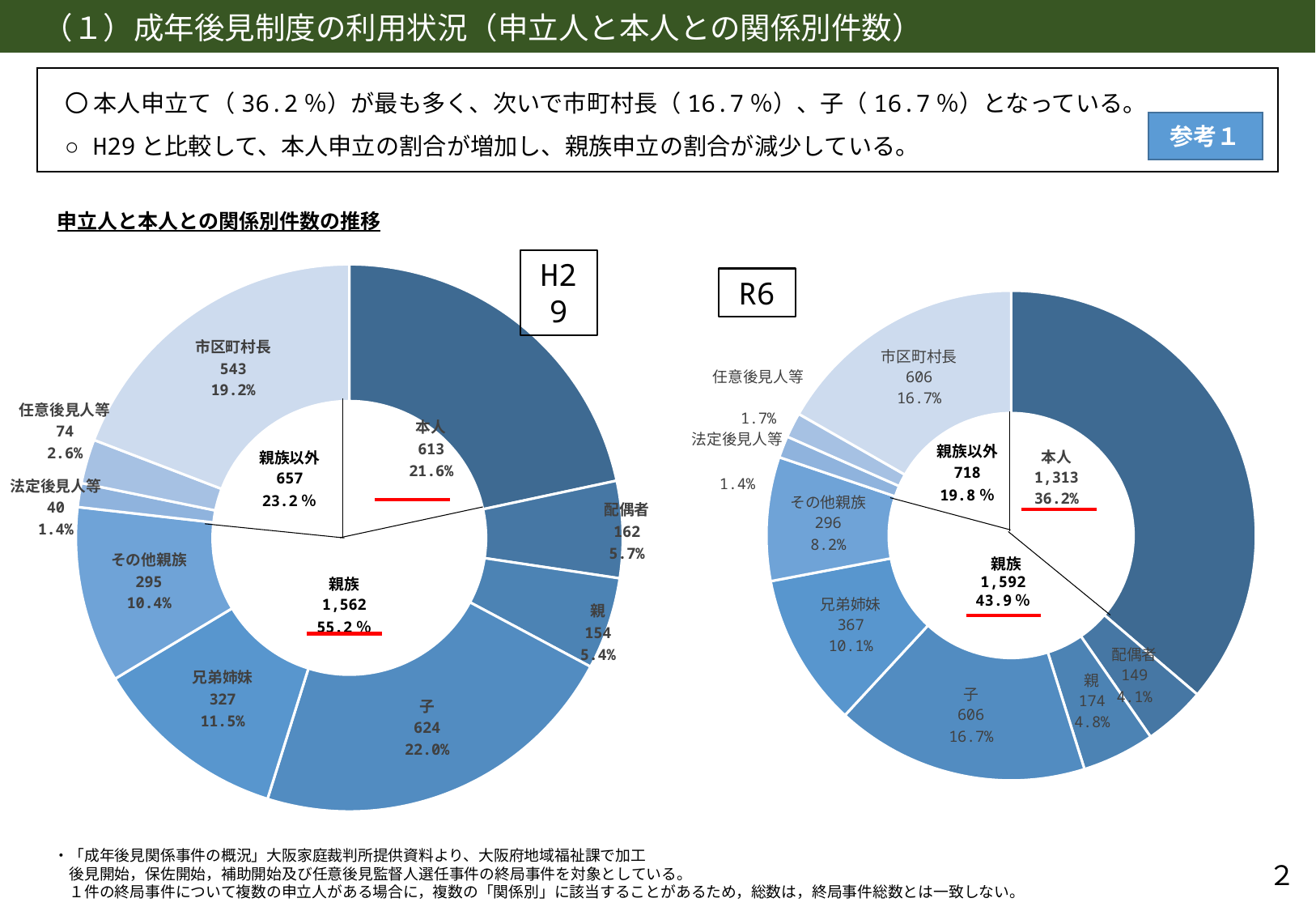
In the H29 chart, what percentage is shown for 親族 in the inner ring? 55.2% In the R6 chart, which has more cases, 兄弟姉妹 or その他親族? 兄弟姉妹 In the R6 chart, what is the number of cases for 市区町村長? 606 In the H29 chart, which category has the largest number of cases? 子 What type of chart is used on this slide? Donut (pie) chart In the R6 chart, what percentage is shown for 本人? 36.2% In the R6 chart, what is the number of cases for 親族以外? 718 In the H29 chart, what is the number of cases for 本人? 613 What is the difference in 本人 cases between R6 and H29? 700 In the R6 chart, which category has the smallest percentage? 法定後見人等 In the H29 chart, what is the difference in cases between 子 and 本人? 11 How many outer-ring categories are shown in the H29 chart? 9